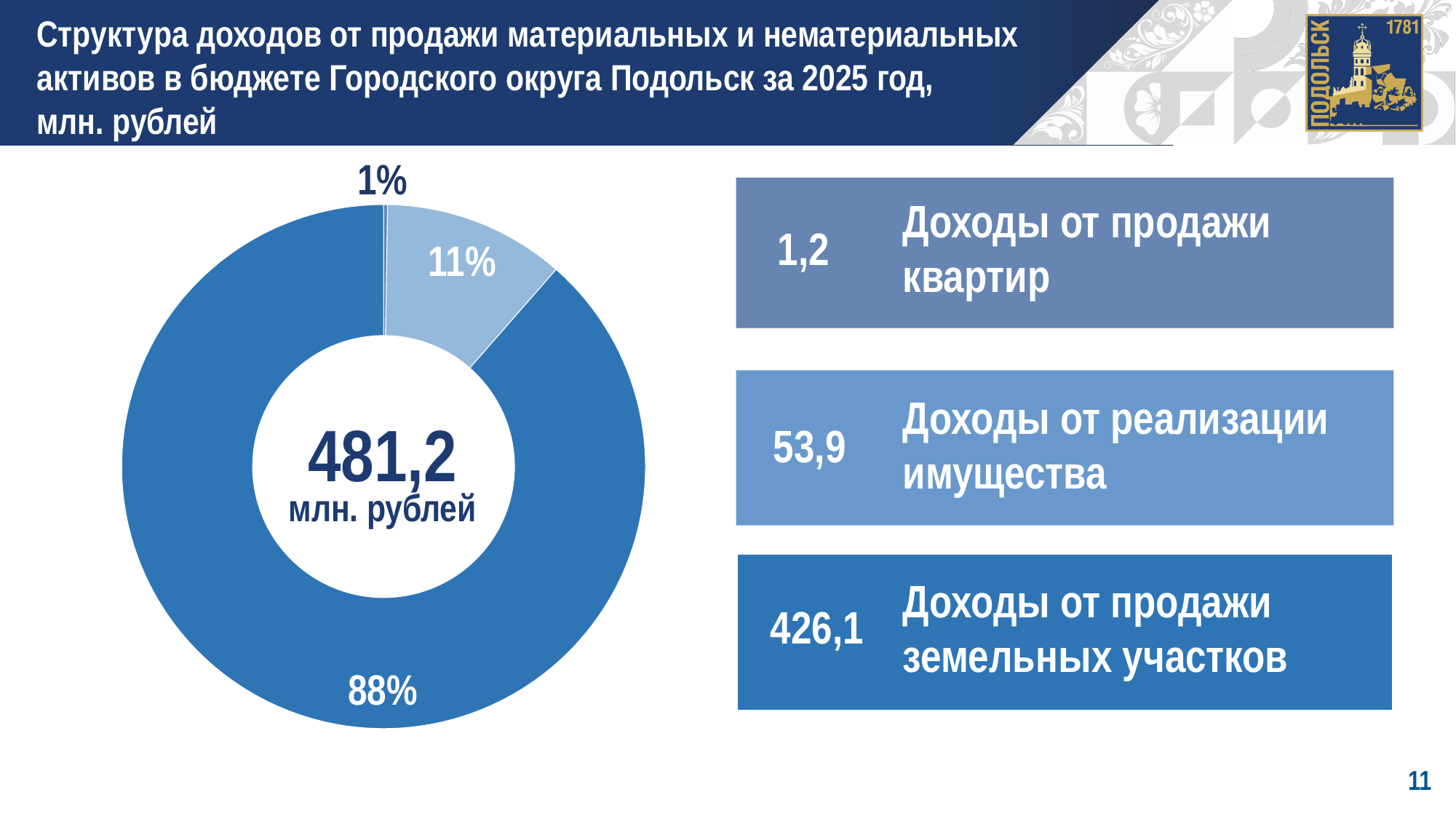
What is the value for 'Доходы от продажи земельных участков'? 426,1 What is the difference between the values for 'Доходы от реализации имущества' and 'Доходы от продажи квартир'? 52,7 How many categories does the chart show? 3 What share of the chart is 'Доходы от реализации имущества'? 11% What is the value for 'Доходы от реализации имущества'? 53,9 What share of the chart is 'Доходы от продажи земельных участков'? 88% What share of the chart is 'Доходы от продажи квартир'? 1% What is the value for 'Доходы от продажи квартир'? 1,2 What is the total shown in the centre of the chart? 481,2 млн. рублей Which category has the largest share of the chart? Доходы от продажи земельных участков Which category has the smallest share of the chart? Доходы от продажи квартир What kind of chart is shown on the slide? Pie chart (donut)